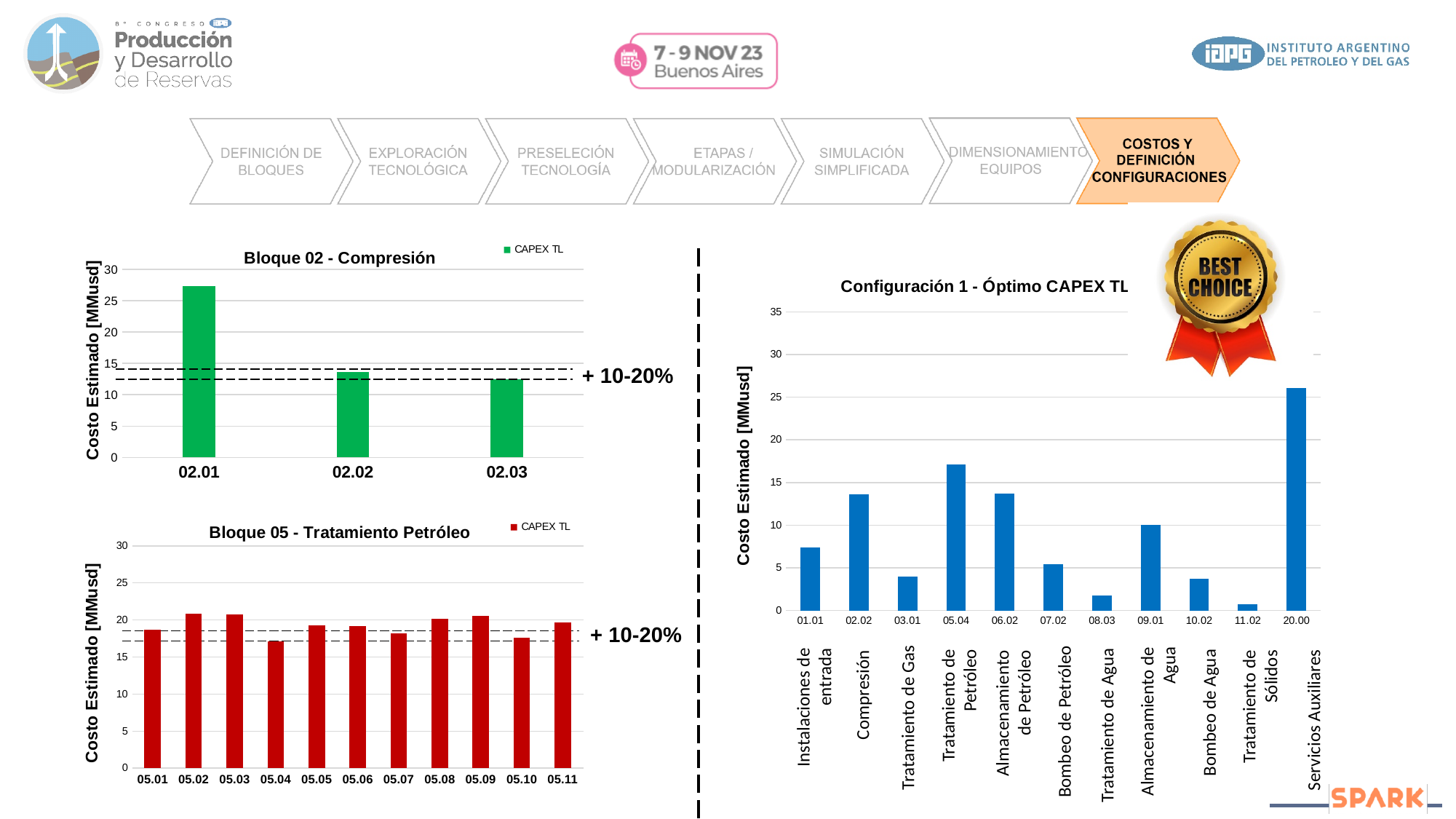
In the 'Bloque 02 - Compresión' chart, how many categories are plotted? 3 In the 'Bloque 02 - Compresión' chart, is the value for 02.01 greater or less than 25? greater In the 'Bloque 05 - Tratamiento Petróleo' chart, which is larger, the value for 05.02 or the value for 05.10? 05.02 In the 'Configuración 1 - Óptimo CAPEX TL' chart, which category has the lowest estimated cost? 11.02 (Tratamiento de Sólidos) In the 'Configuración 1 - Óptimo CAPEX TL' chart, which category has the highest estimated cost? 20.00 (Servicios Auxiliares) What type of chart is 'Bloque 05 - Tratamiento Petróleo'? bar chart In the 'Bloque 05 - Tratamiento Petróleo' chart, how many categories are plotted? 11 In the 'Bloque 02 - Compresión' chart, which category has the highest estimated cost? 02.01 In the 'Configuración 1 - Óptimo CAPEX TL' chart, how many categories are plotted? 11 In the 'Configuración 1 - Óptimo CAPEX TL' chart, is the value for 05.04 (Tratamiento de Petróleo) greater or less than 15? greater In the 'Bloque 05 - Tratamiento Petróleo' chart, is the value for 05.04 greater or less than 20? less In the 'Bloque 02 - Compresión' chart, which series does the legend list? CAPEX TL